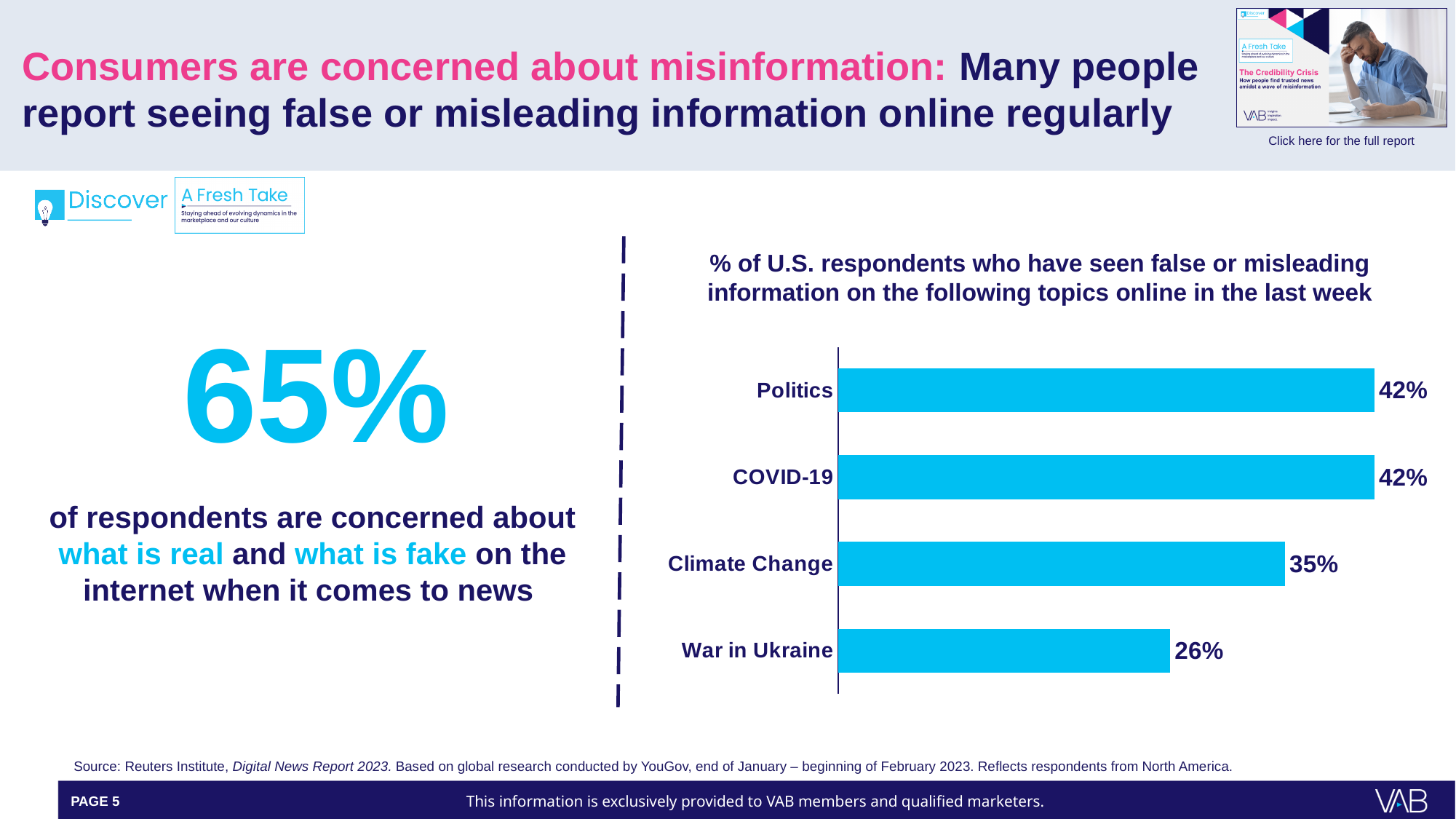
How many topics are shown in the bar chart? 4 What is the difference between the values for Politics and War in Ukraine? 16% What is the value shown for Climate Change in the bar chart? 35% Do the values in the bar chart rise or fall from the top bar (Politics) to the bottom bar (War in Ukraine)? Fall Which is larger, the value for Climate Change or the value for War in Ukraine? Climate Change What is the title of the bar chart? % of U.S. respondents who have seen false or misleading information on the following topics online in the last week What is the value shown for COVID-19 in the bar chart? 42% Which topic has the lowest percentage in the bar chart? War in Ukraine What is the difference between the values for COVID-19 and Climate Change? 7% What percentage of U.S. respondents have seen false or misleading information about Politics online in the last week? 42% What is the value shown for War in Ukraine in the bar chart? 26% What kind of chart is used to show the percentages by topic? Bar chart